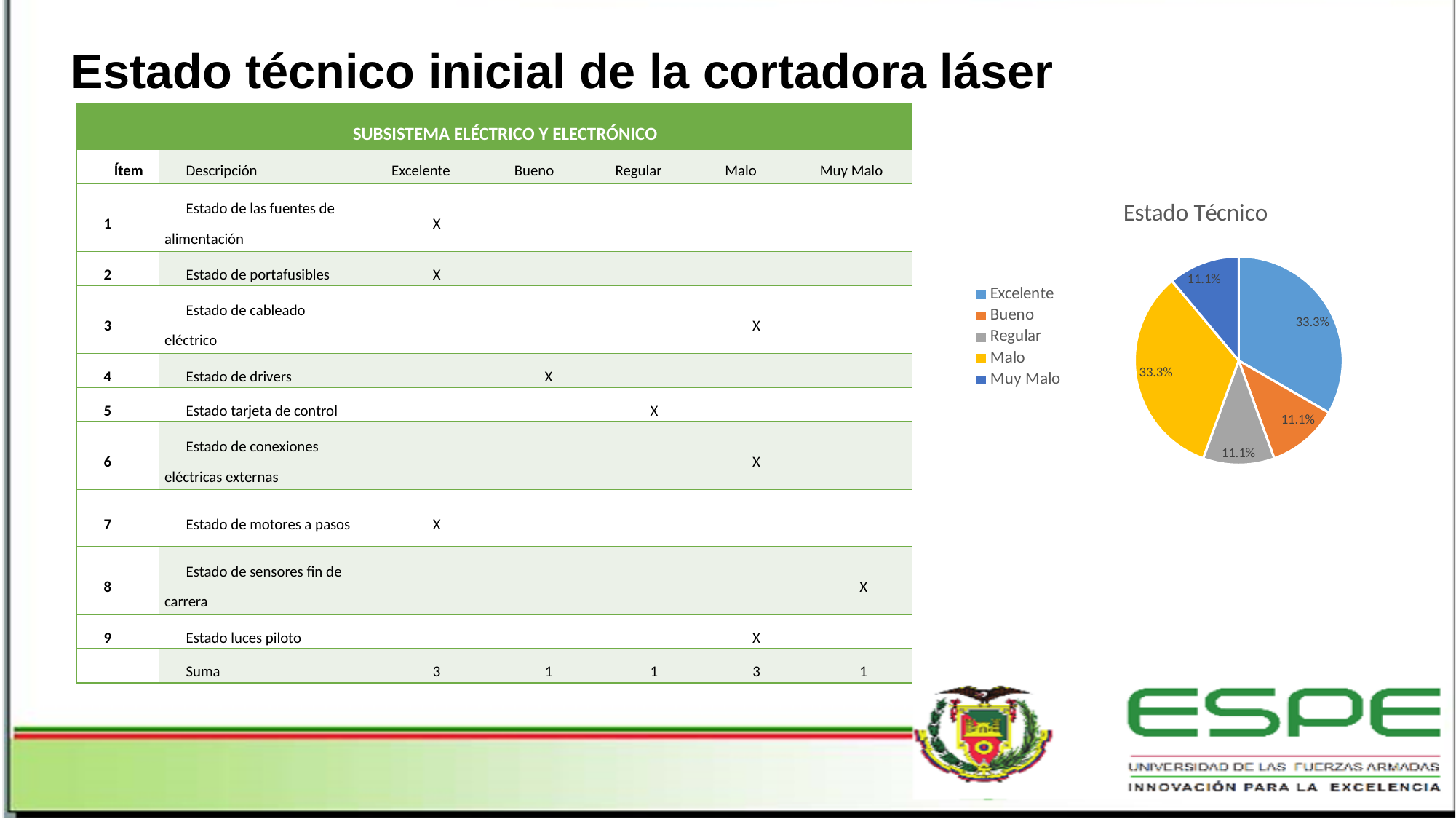
What is the title of the chart? Estado Técnico Which colour represents Malo in the pie chart? yellow Which is larger in the pie chart, Excelente or Regular? Excelente What share of the pie chart does Excelente represent? 33.3% What share of the pie chart does Malo represent? 33.3% What kind of chart is shown on the slide? pie chart How many slices does the pie chart have? 5 What is the difference between the shares of Malo and Bueno in the pie chart? 22.2% How many categories does the legend of the pie chart list? 5 What share of the pie chart does Bueno represent? 11.1% Do Excelente and Malo have the same share in the pie chart? yes